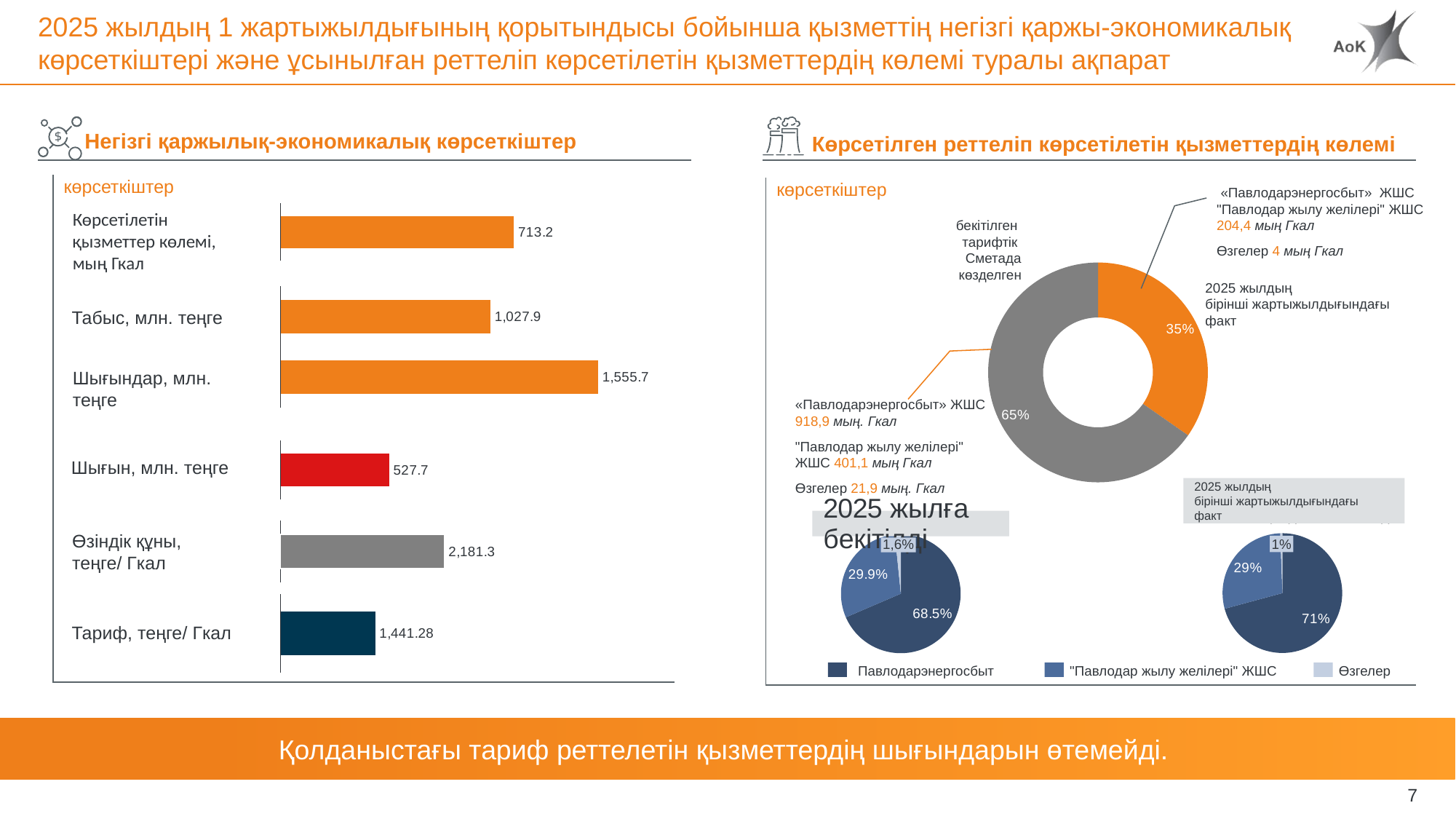
What type of chart is used for 'Негізгі қаржылық-экономикалық көрсеткіштер' on the left of the slide? Bar chart In the bar chart 'Негізгі қаржылық-экономикалық көрсеткіштер', which category has the highest value? Өзіндік құны, теңге/ Гкал In the bar chart 'Негізгі қаржылық-экономикалық көрсеткіштер', what is the difference between 'Шығындар, млн. теңге' and 'Табыс, млн. теңге'? 527.8 How many entries does the legend below the two small pie charts list? 3 In the bar chart 'Негізгі қаржылық-экономикалық көрсеткіштер', what is the value for 'Тариф, теңге/ Гкал'? 1,441.28 How many categories are shown in the bar chart 'Негізгі қаржылық-экономикалық көрсеткіштер'? 6 In the bar chart 'Негізгі қаржылық-экономикалық көрсеткіштер', what is the value for 'Табыс, млн. теңге'? 1,027.9 In the donut chart on the right side of the slide, what share is labelled for '2025 жылдың бірінші жартыжылдығындағы факт'? 35% In the bar chart 'Негізгі қаржылық-экономикалық көрсеткіштер', which is larger: 'Өзіндік құны, теңге/ Гкал' or 'Тариф, теңге/ Гкал'? Өзіндік құны, теңге/ Гкал In the bar chart 'Негізгі қаржылық-экономикалық көрсеткіштер', which category has the lowest value? Шығын, млн. теңге In the donut chart on the right side of the slide, what share is labelled for 'бекітілген тарифтік Сметада көзделген'? 65% In the small pie chart '2025 жылға бекітілді', what share does 'Павлодарэнергосбыт' have? 68.5%